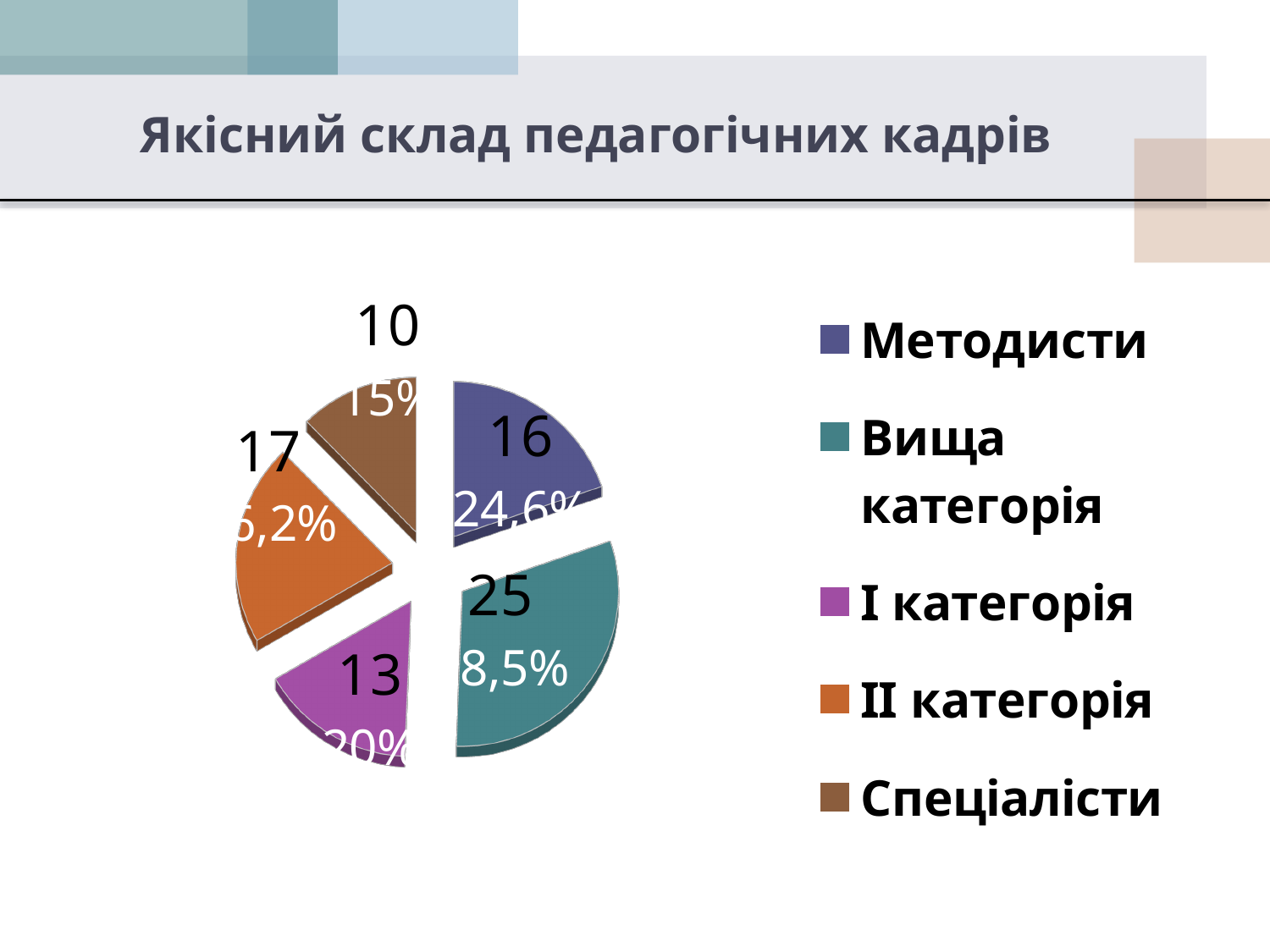
What is the difference between the values for Вища категорія and Методисти? 9 Which category has the largest slice? Вища категорія What is the value for Методисти? 16 What is the value for I категорія? 13 What kind of chart is shown on the slide? pie chart How many slices does the pie chart have? 5 What is the value for II категорія? 17 How many entries does the legend list? 5 What is the title of the chart? Якісний склад педагогічних кадрів Which category has the smallest slice? Спеціалісти What is the value for Вища категорія? 25 What is the value for Спеціалісти? 10